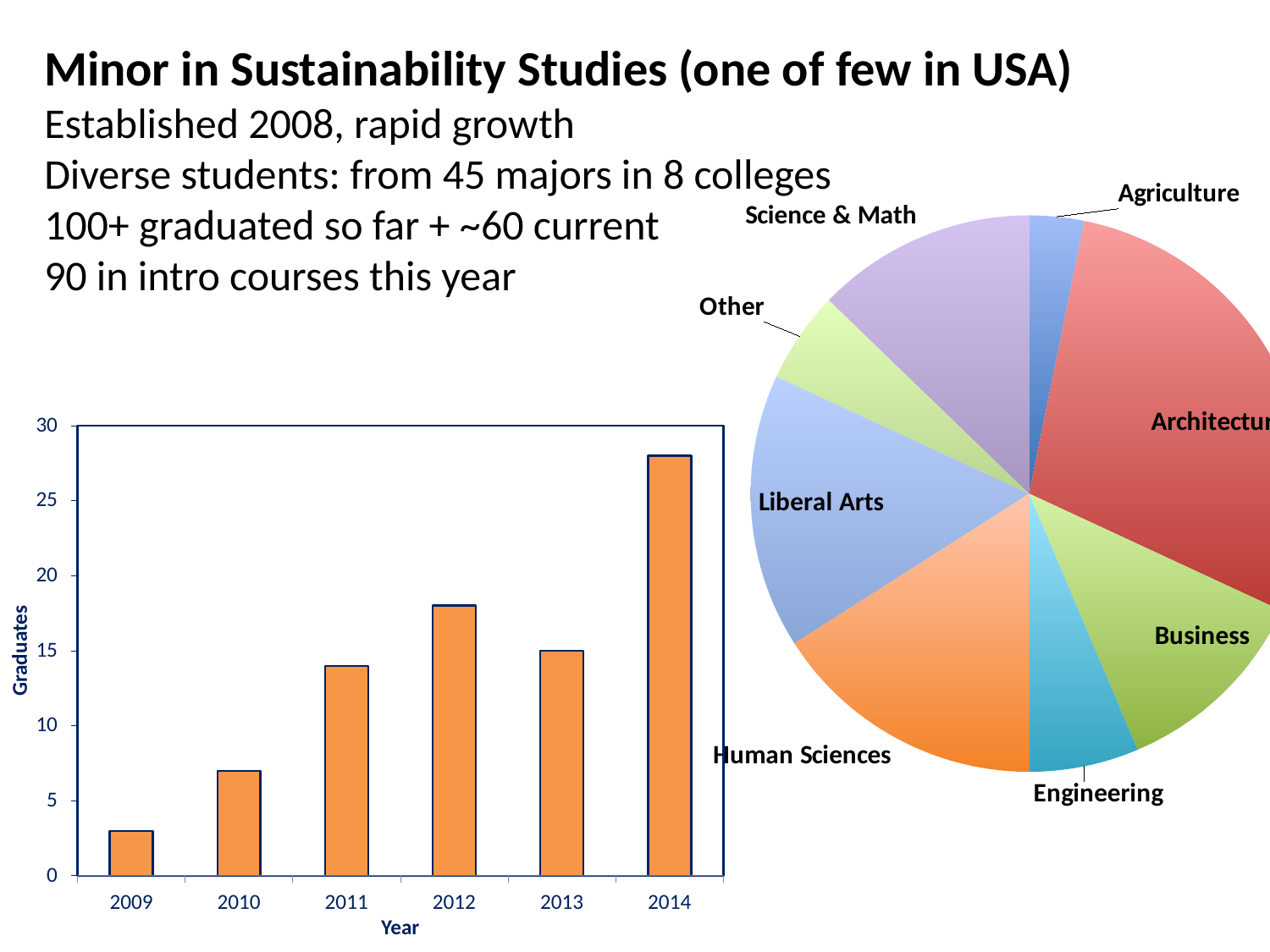
In the pie chart on the right, which college has the largest slice? Architecture In the pie chart on the right, which slice is larger, Liberal Arts or Engineering? Liberal Arts What kind of chart is the chart on the left of the slide? bar chart In the bar chart on the left, which year has more graduates, 2012 or 2013? 2012 In the bar chart on the left, is the value for 2014 greater or less than 25? greater In the pie chart on the right, which college has the smallest slice? Agriculture In the bar chart on the left, is the value for 2012 greater or less than 20? less In the bar chart on the left, which year has the lowest number of graduates? 2009 What kind of chart is the chart on the right of the slide? pie chart In the bar chart on the left, is the value for 2009 greater or less than 5? less In the bar chart on the left, how many years are shown on the x axis? 6 In the bar chart on the left, which year has the highest number of graduates? 2014